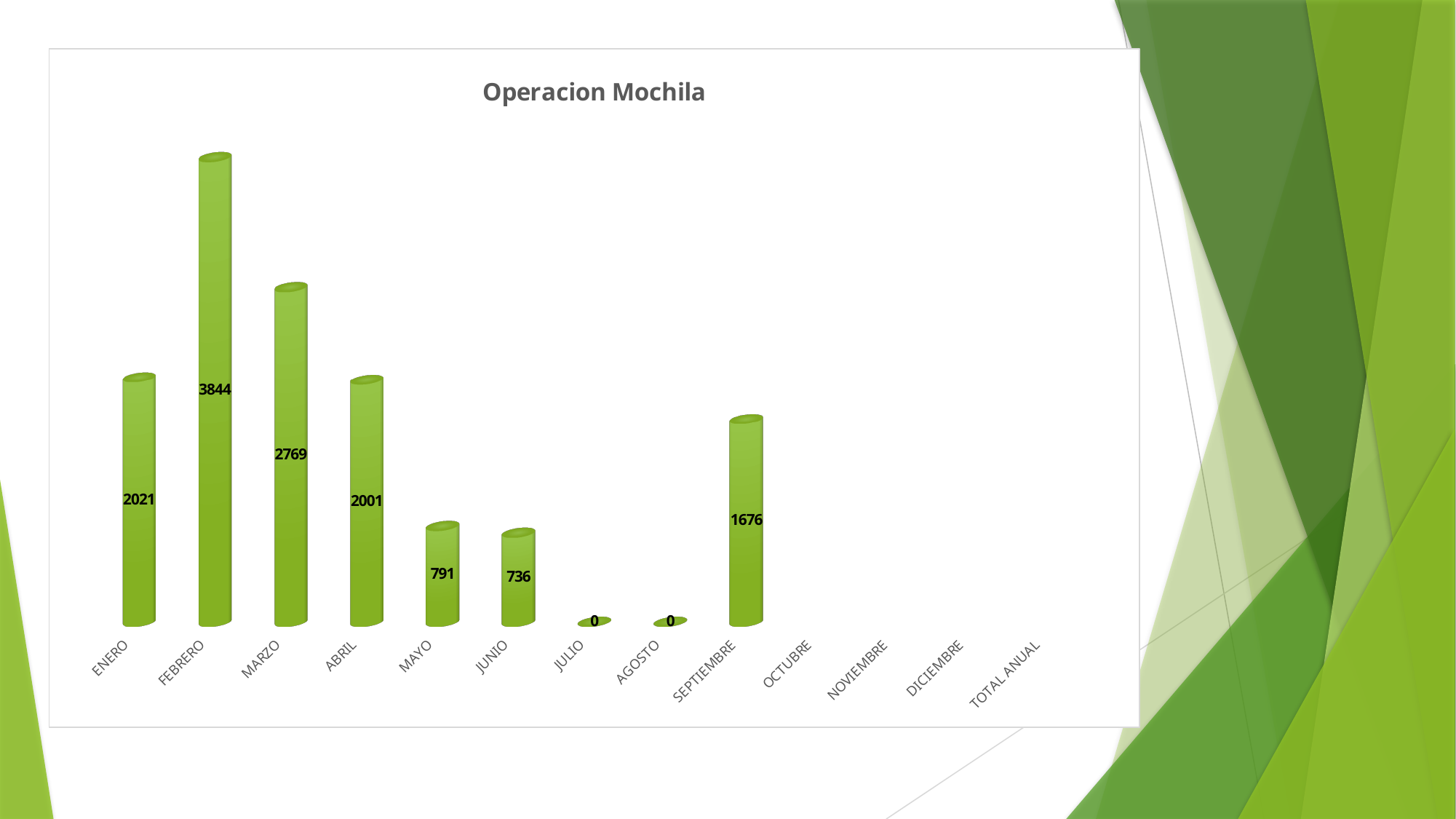
What is the difference between the values for ENERO and ABRIL? 20 What kind of chart is shown on the slide? Bar chart What is the value for SEPTIEMBRE? 1676 What is the value for FEBRERO in the Operacion Mochila chart? 3844 What is the difference between the values for FEBRERO and MARZO? 1075 Which is larger, the value for MAYO or the value for JUNIO? MAYO What is the value for JULIO? 0 How many categories are listed along the x axis? 13 What is the title of the chart? Operacion Mochila Do the values rise or fall from FEBRERO to JUNIO? Fall Which month has the highest value? FEBRERO What is the value for MAYO? 791